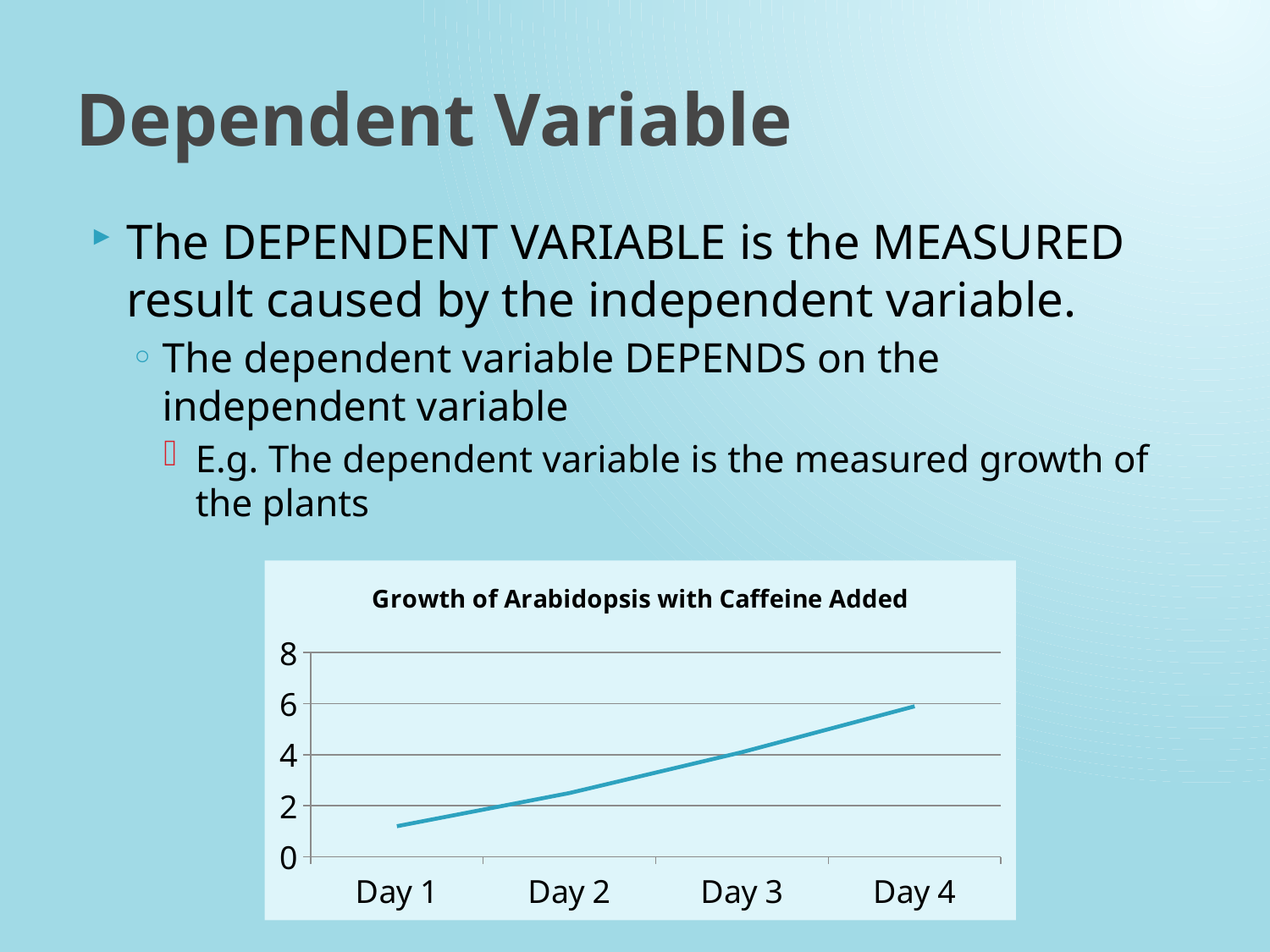
Is the value for Day 1 greater or less than 2? less Which day has the highest growth value? Day 4 Is the value for Day 2 greater or less than 4? less Which is larger, the value for Day 4 or the value for Day 2? Day 4 What is the highest value shown on the y axis of the chart? 8 Is the value for Day 3 greater or less than 2? greater Which day has the lowest growth value? Day 1 How many days are plotted along the x axis of the chart? 4 Does the plotted growth rise or fall from Day 1 to Day 4? Rise What kind of chart is shown on the slide? Line chart What is the title of the chart? Growth of Arabidopsis with Caffeine Added